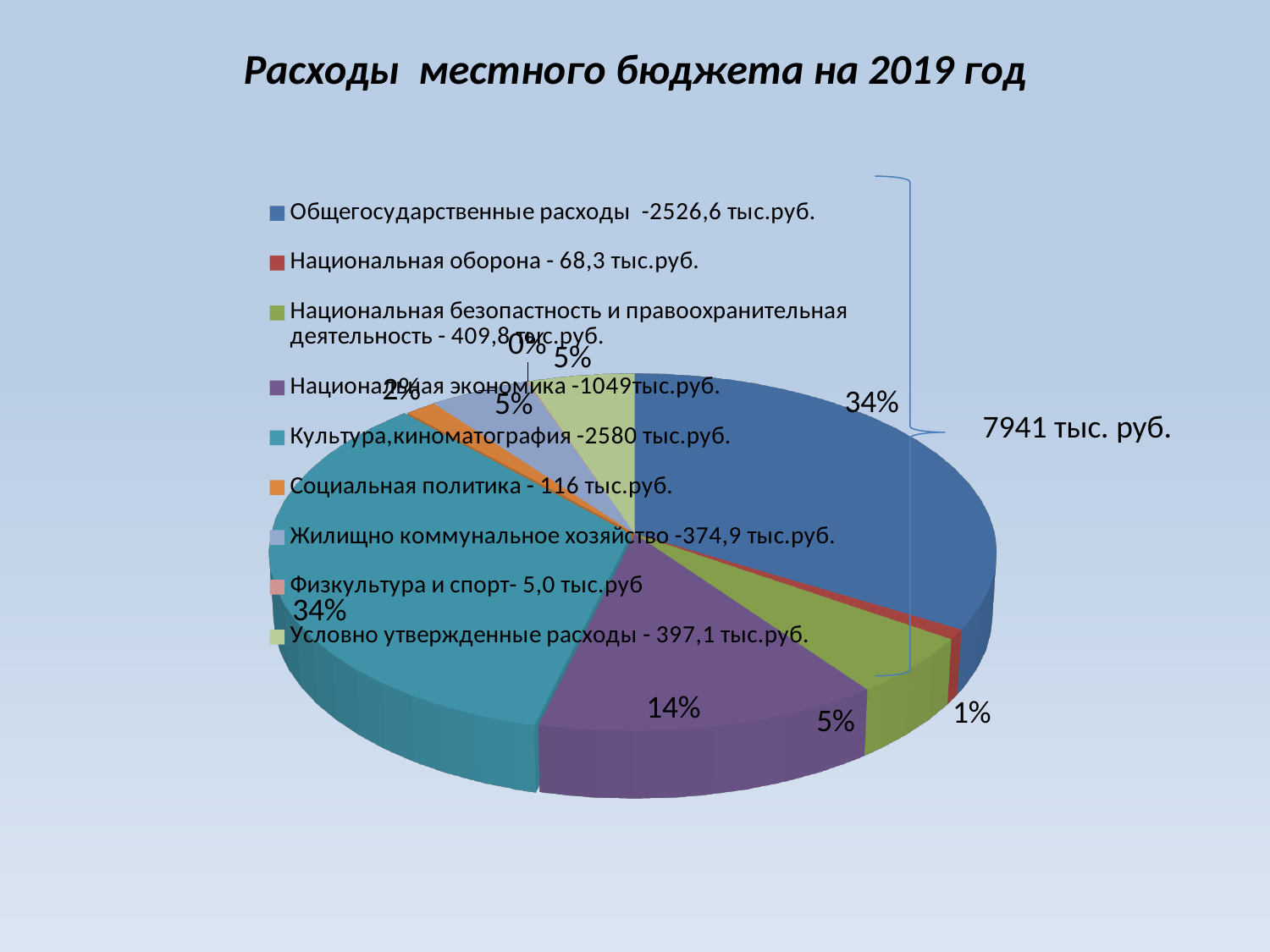
What kind of chart is shown on the slide? pie chart Which is larger according to the legend: Национальная экономика or Национальная безопастность и правоохранительная деятельность? Национальная экономика What value is given in the legend for Культура,киноматография? 2580 тыс.руб. What share of the pie does Общегосударственные расходы take? 34% Which category has the smallest value according to the legend? Физкультура и спорт How many categories does the legend list? 9 What total amount is shown next to the pie? 7941 тыс. руб. What share of the pie does Социальная политика take? 2% What value is given in the legend for Жилищно коммунальное хозяйство? 374,9 тыс.руб. What share of the pie does Национальная экономика take? 14% What is the title of the chart? Расходы местного бюджета на 2019 год